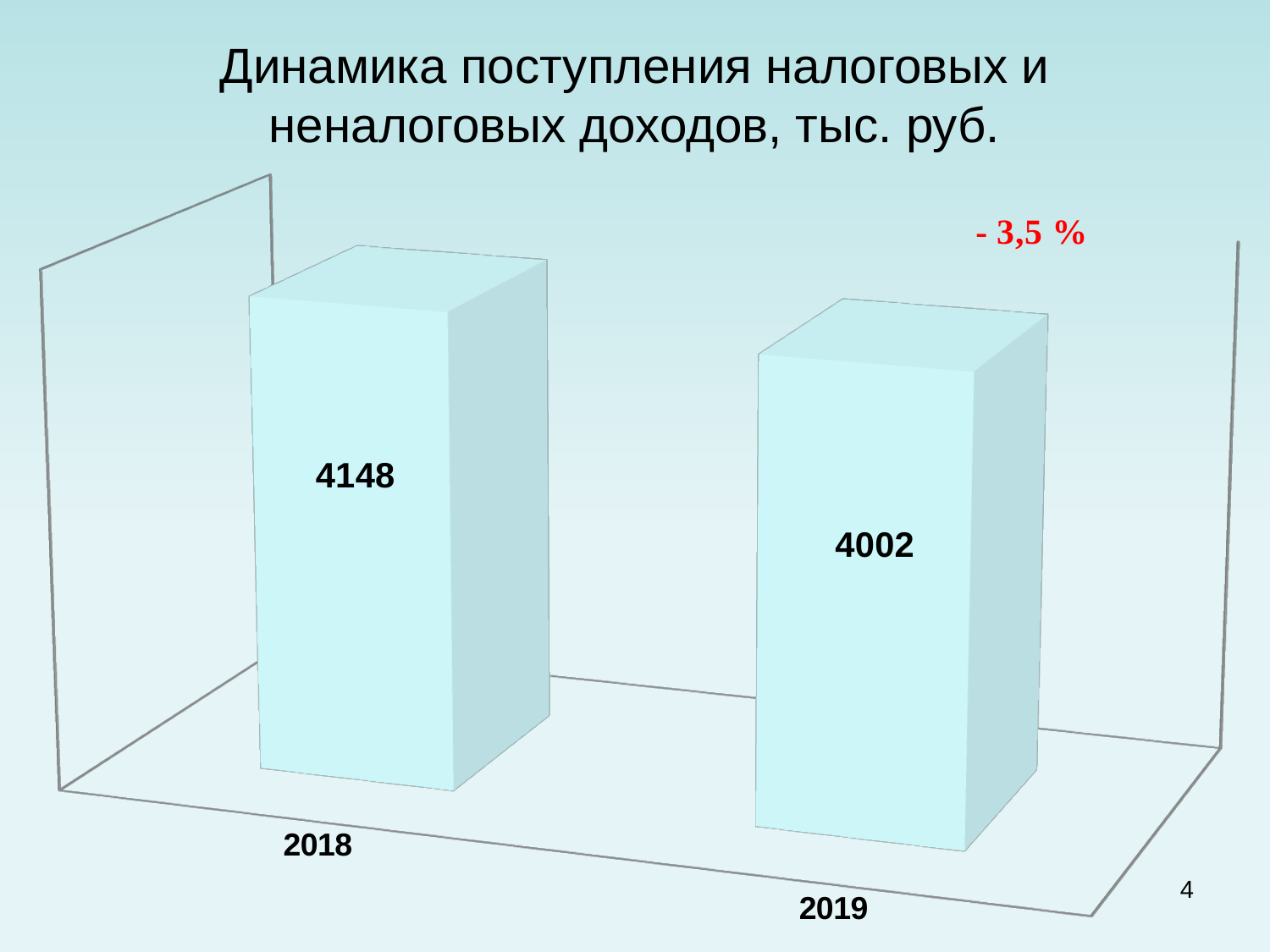
What unit is given in the chart title? тыс. руб. Which year has the lower value? 2019 What is the value for 2018? 4148 Which year has the higher value? 2018 What is the difference between the 2018 and 2019 values? 146 How many categories are shown on the chart? 2 Do the values rise or fall from 2018 to 2019? fall What is the value for 2019? 4002 Is the value for 2019 larger or smaller than the value for 2018? smaller What kind of chart is shown on the slide? bar chart What percentage change is annotated in red on the chart? - 3,5 %